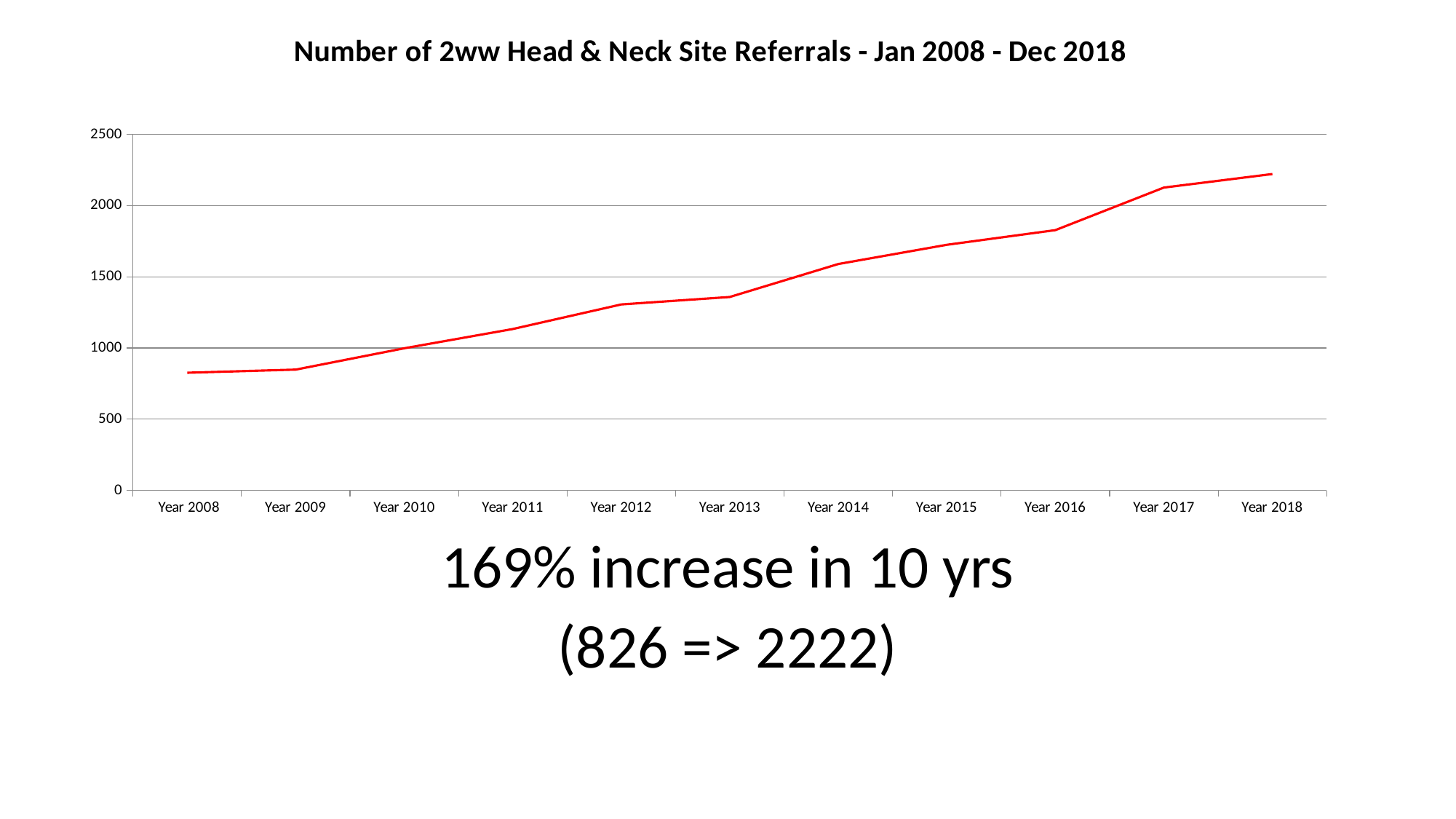
What is the title of the chart? Number of 2ww Head & Neck Site Referrals - Jan 2008 - Dec 2018 What is the difference in referrals between Year 2018 and Year 2008? 1396 Which year has the highest number of referrals? Year 2018 Which year has the lowest number of referrals? Year 2008 Which year has more referrals, Year 2012 or Year 2015? Year 2015 Is the value for Year 2013 greater or less than 1500? less What is the number of referrals for Year 2018? 2222 Is the value for Year 2016 greater or less than 1500? greater Do the referral numbers rise or fall from Year 2008 to Year 2018? Rise How many years are plotted on the x axis of the chart? 11 What is the number of referrals for Year 2008? 826 What type of chart is shown on the slide? Line chart